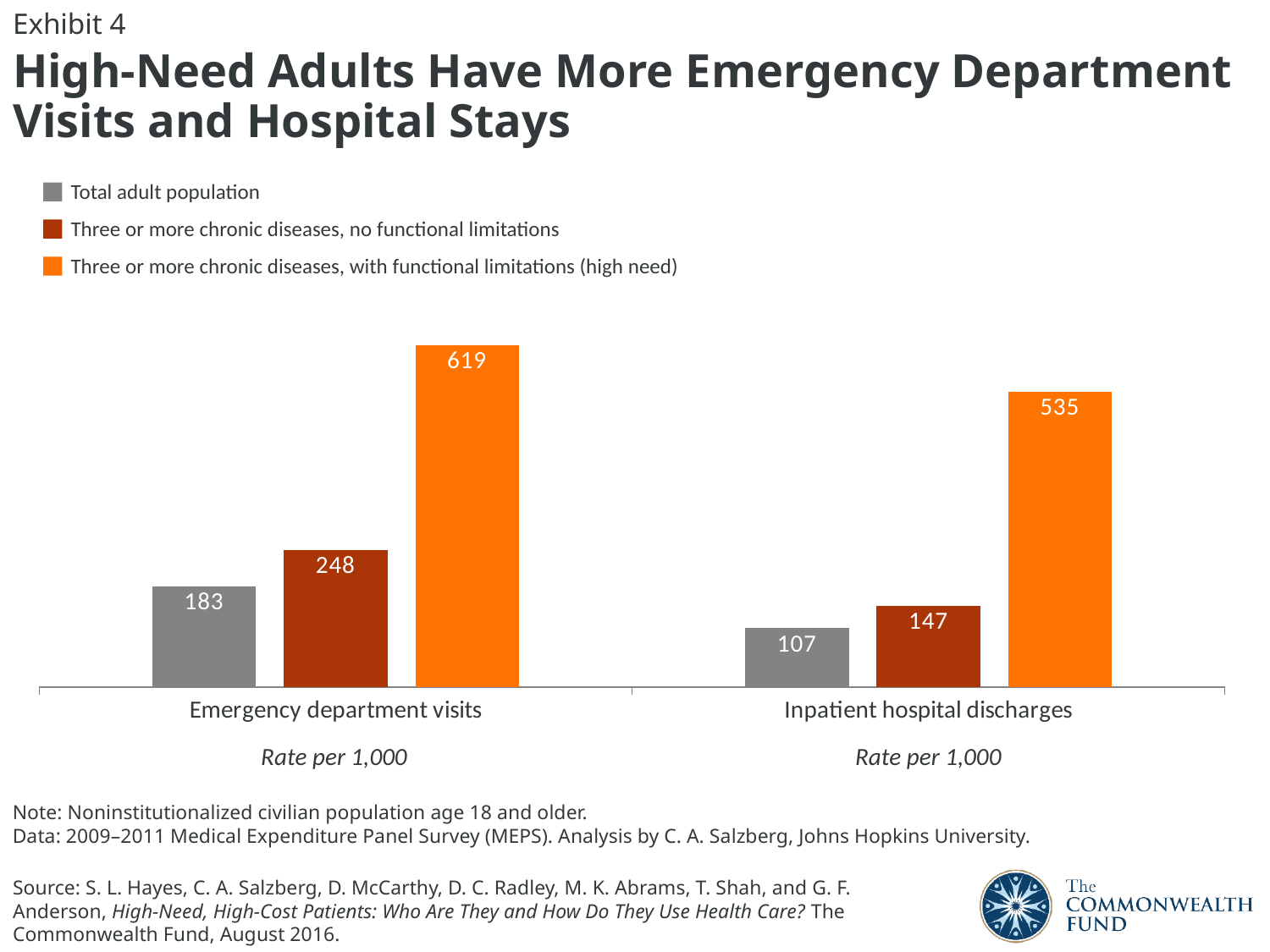
What is the rate of inpatient hospital discharges per 1,000 for adults with three or more chronic diseases, with functional limitations (high need)? 535 Which group has the lowest rate of inpatient hospital discharges? Total adult population How many series does the legend list? 3 Which group has the highest rate of emergency department visits? Three or more chronic diseases, with functional limitations (high need) What is the difference between the inpatient hospital discharge rates for the high-need group and the group with three or more chronic diseases, no functional limitations? 388 What kind of chart is shown on the slide? Bar chart What is the difference between the emergency department visit rates for the high-need group and the total adult population? 436 What colour represents the high-need group in the chart? Orange What is the rate of emergency department visits per 1,000 for the total adult population? 183 Which is larger: the emergency department visit rate for the high-need group or the inpatient hospital discharge rate for the high-need group? Emergency department visit rate (619) How many categories are shown on the x axis? 2 What is the rate of emergency department visits per 1,000 for adults with three or more chronic diseases, no functional limitations? 248